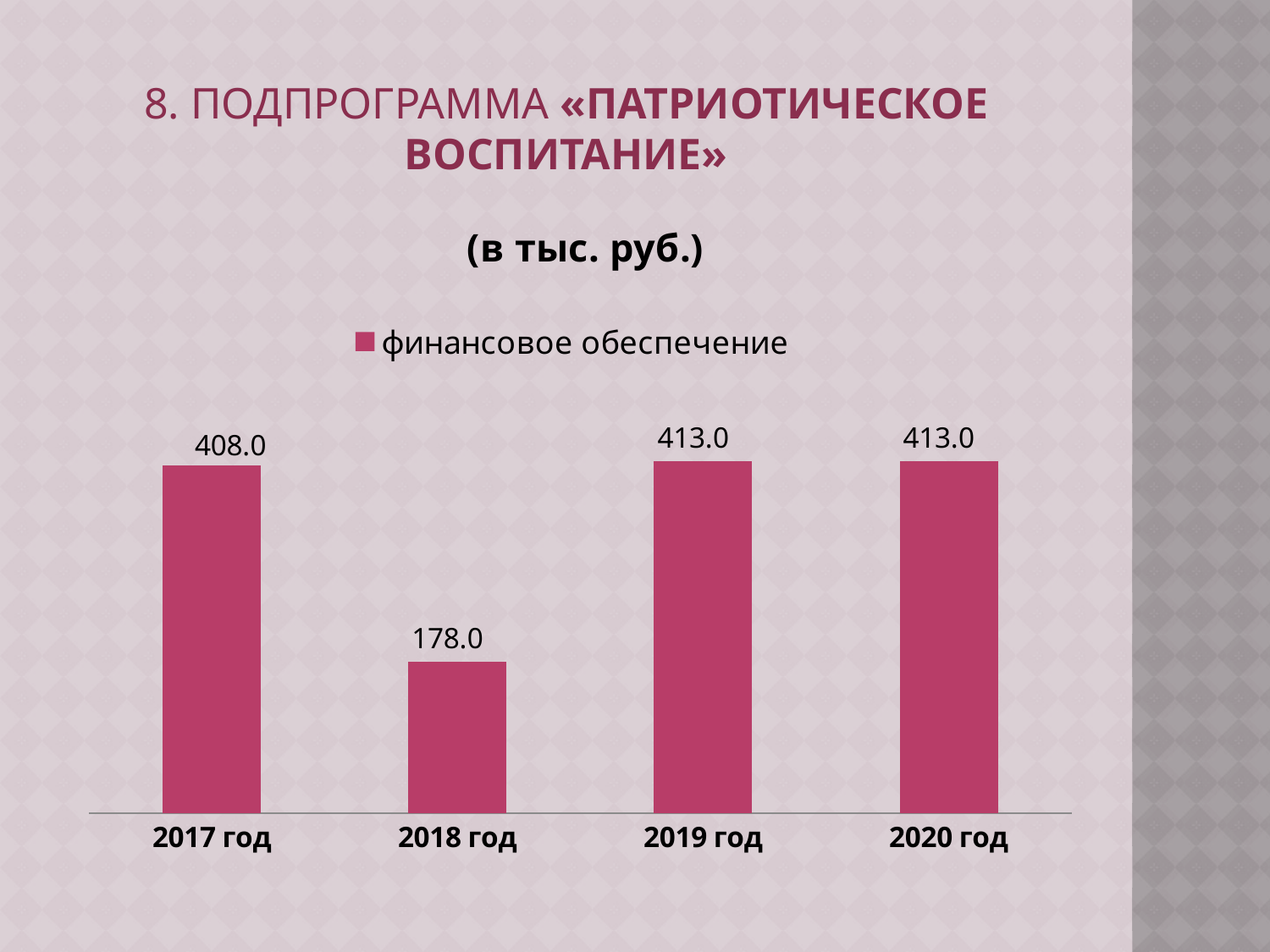
Which is larger, the value for 2017 год or the value for 2018 год? 2017 год What is the difference between the values for 2019 год and 2018 год? 235.0 What is the name of the series in the legend? финансовое обеспечение What is the value for 2019 год? 413.0 What is the difference between the values for 2017 год and 2018 год? 230.0 How many years are shown on the x axis? 4 What is the value for 2020 год? 413.0 How many series does the legend list? 1 What kind of chart is shown on the slide? bar chart Which year has the lowest value? 2018 год What is the value for 2018 год? 178.0 What is the value for 2017 год? 408.0